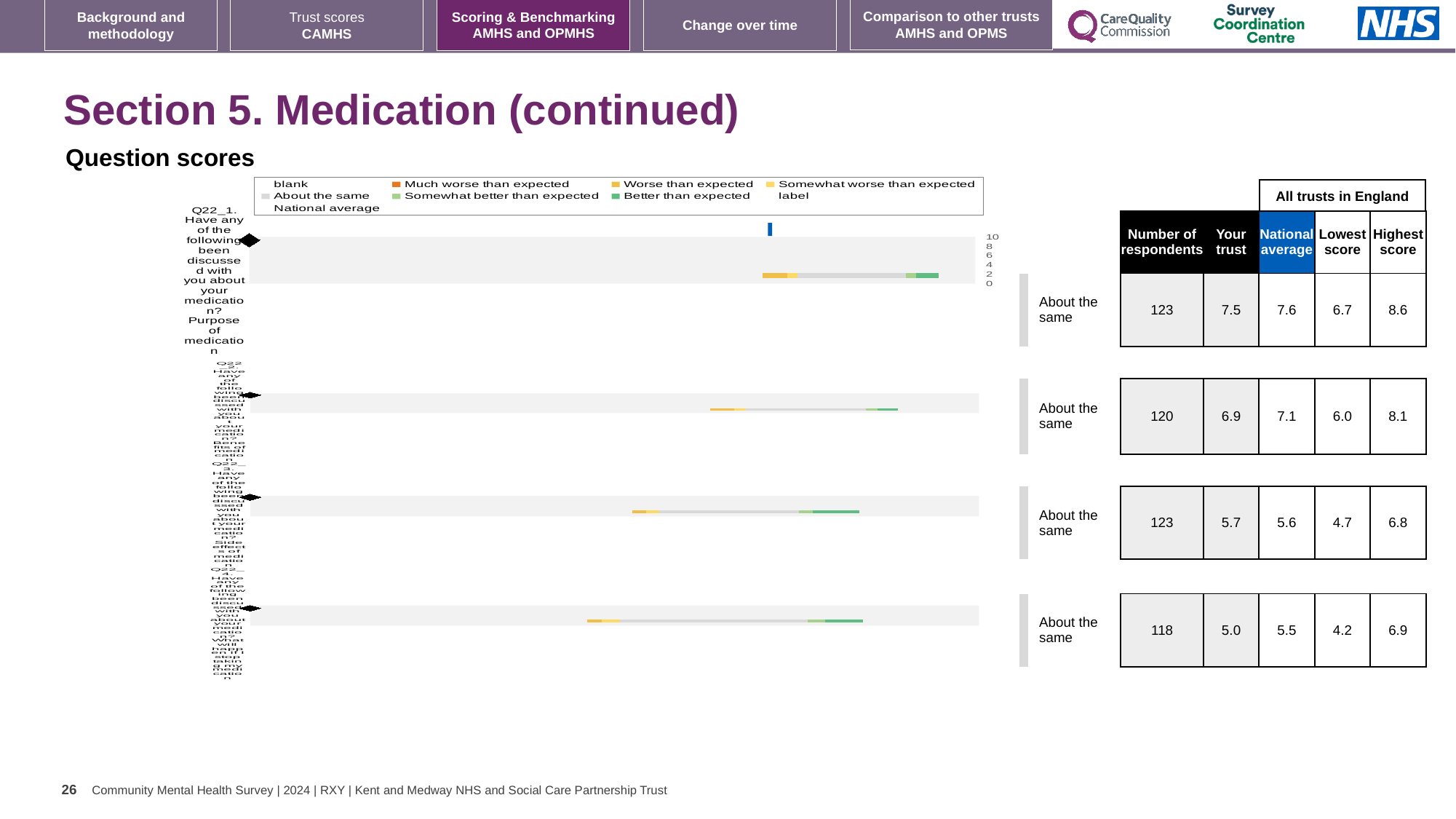
Is the 'Your trust' score for the first question (Q22_1) greater or less than 6? greater Which question has the highest 'Your trust' score? Q22_1 (Purpose of medication) How many respondents are listed for the fourth question (Q22_4)? 118 What is the difference between the highest score and the lowest score for the first question (Q22_1)? 1.9 Which question has the lowest 'Your trust' score? the fourth question (Q22_4) What is the heading above the chart? Question scores What benchmark label is shown next to each of the four question bars? About the same What is the national average for the first question (Q22_1, Purpose of medication)? 7.6 For the third question (Q22_3), which is larger: the 'Your trust' score or the national average? Your trust What is the 'Your trust' score for the first question (Q22_1, Purpose of medication)? 7.5 What kind of chart is shown under 'Question scores'? bar chart How many question bars are plotted in the chart? 4